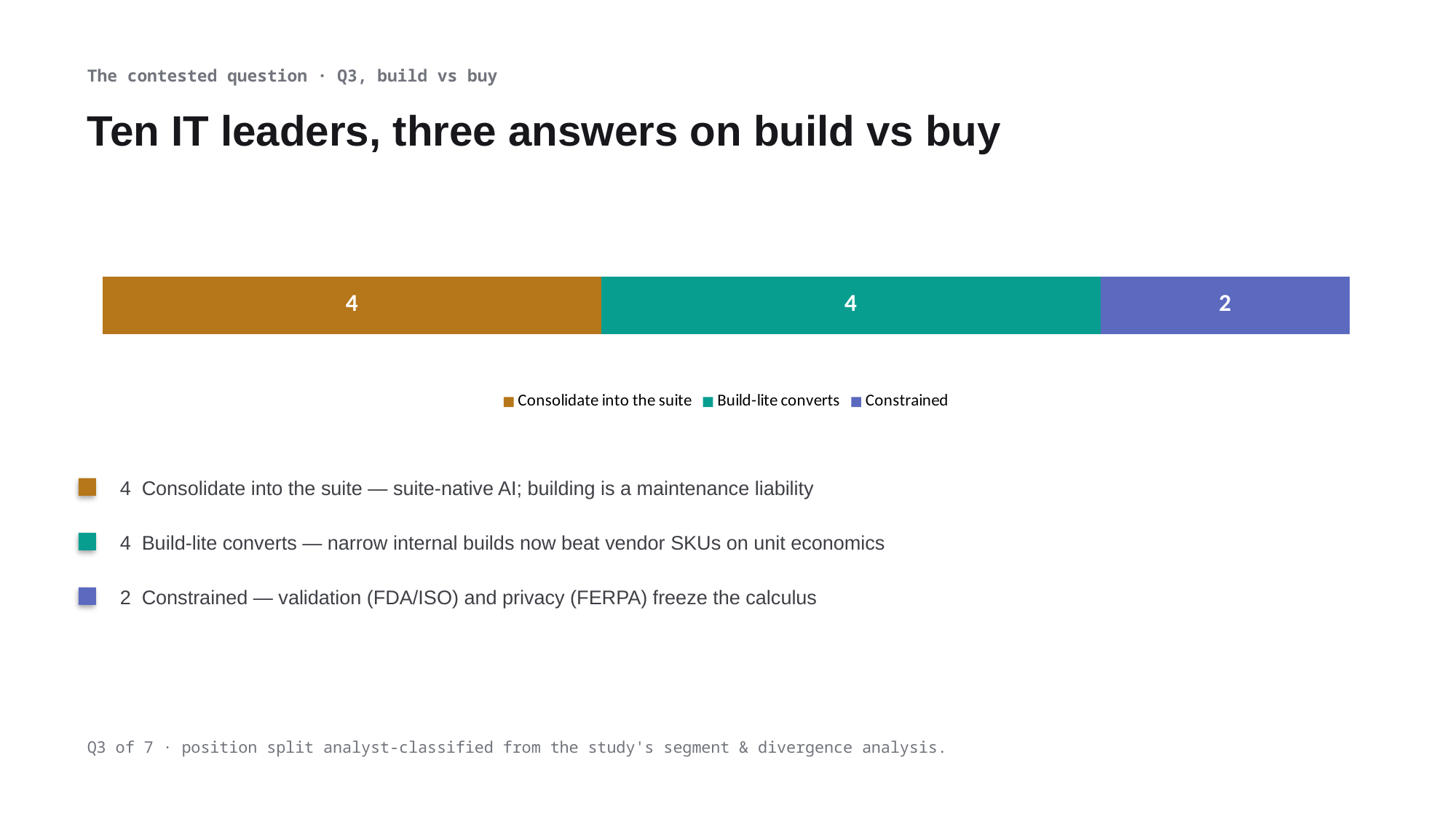
How many series does the legend list? 3 Which legend entry is shown in orange-brown? Consolidate into the suite Is the value for Constrained greater or less than the value for Consolidate into the suite? less Which is larger, the Build-lite converts value or the Constrained value? Build-lite converts What is the total of all segments in the stacked bar? 10 What value is shown for the Build-lite converts segment? 4 What is the difference between the Consolidate into the suite value and the Constrained value? 2 Which segment has the lowest value? Constrained What kind of chart is shown on the slide? Stacked bar chart What value is shown for the Constrained segment? 2 What value is shown for the Consolidate into the suite segment? 4 Which legend entry is shown in blue-purple? Constrained